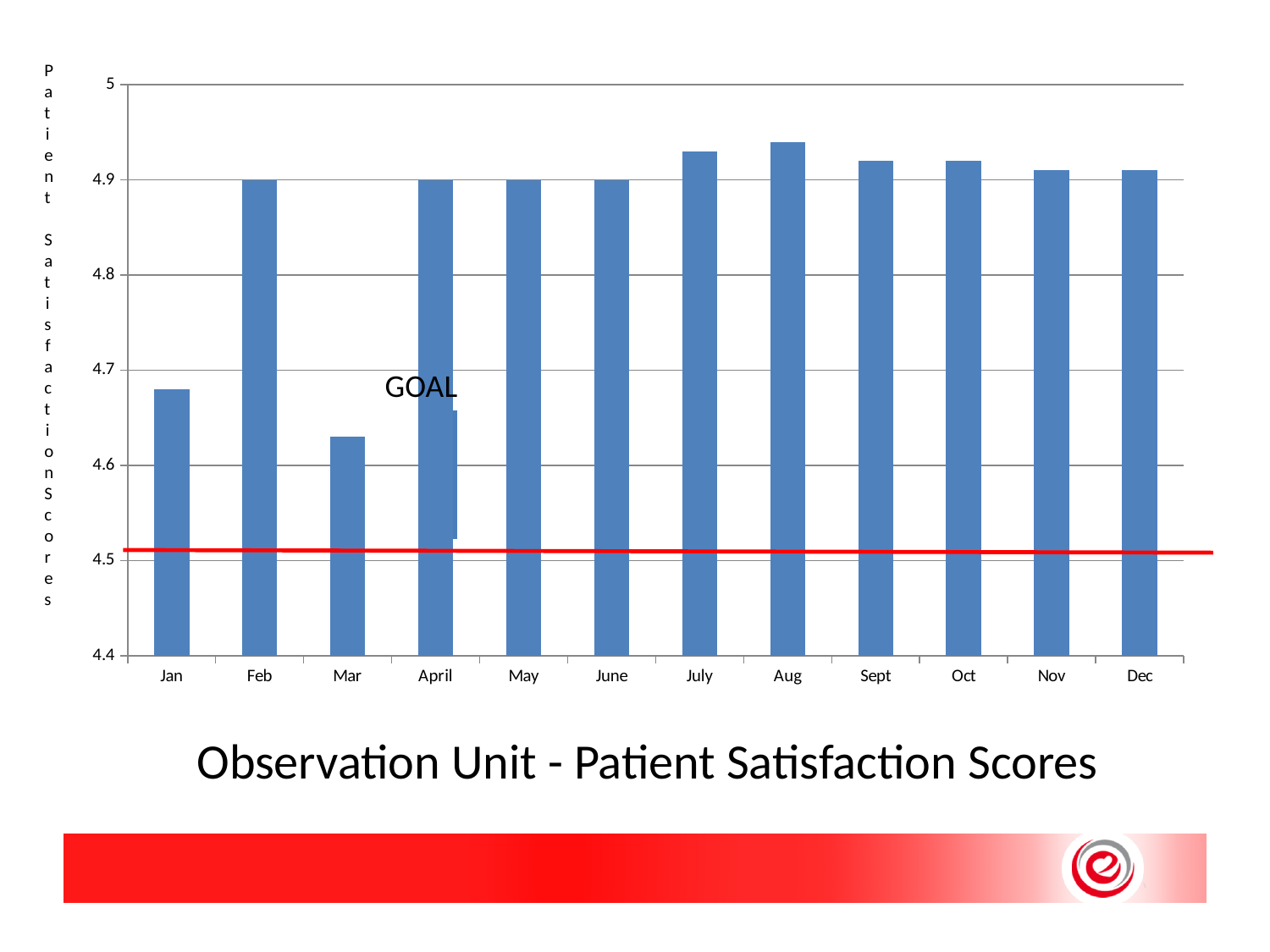
What is the patient satisfaction score for May? 4.9 What is the patient satisfaction score for Feb? 4.9 Which is larger, the score for Feb or the score for Jan? Feb What kind of chart is shown on the slide? bar chart Which is larger, the score for Jan or the score for Mar? Jan What label is attached to the red horizontal line on the chart? GOAL How many months are plotted on the x axis? 12 What is the title of the chart? Observation Unit - Patient Satisfaction Scores Is the value for Aug greater or less than 4.9? greater Which month has the lowest patient satisfaction score? Mar Is the value for Jan greater or less than 4.7? less Is the value for Mar greater or less than 4.6? greater